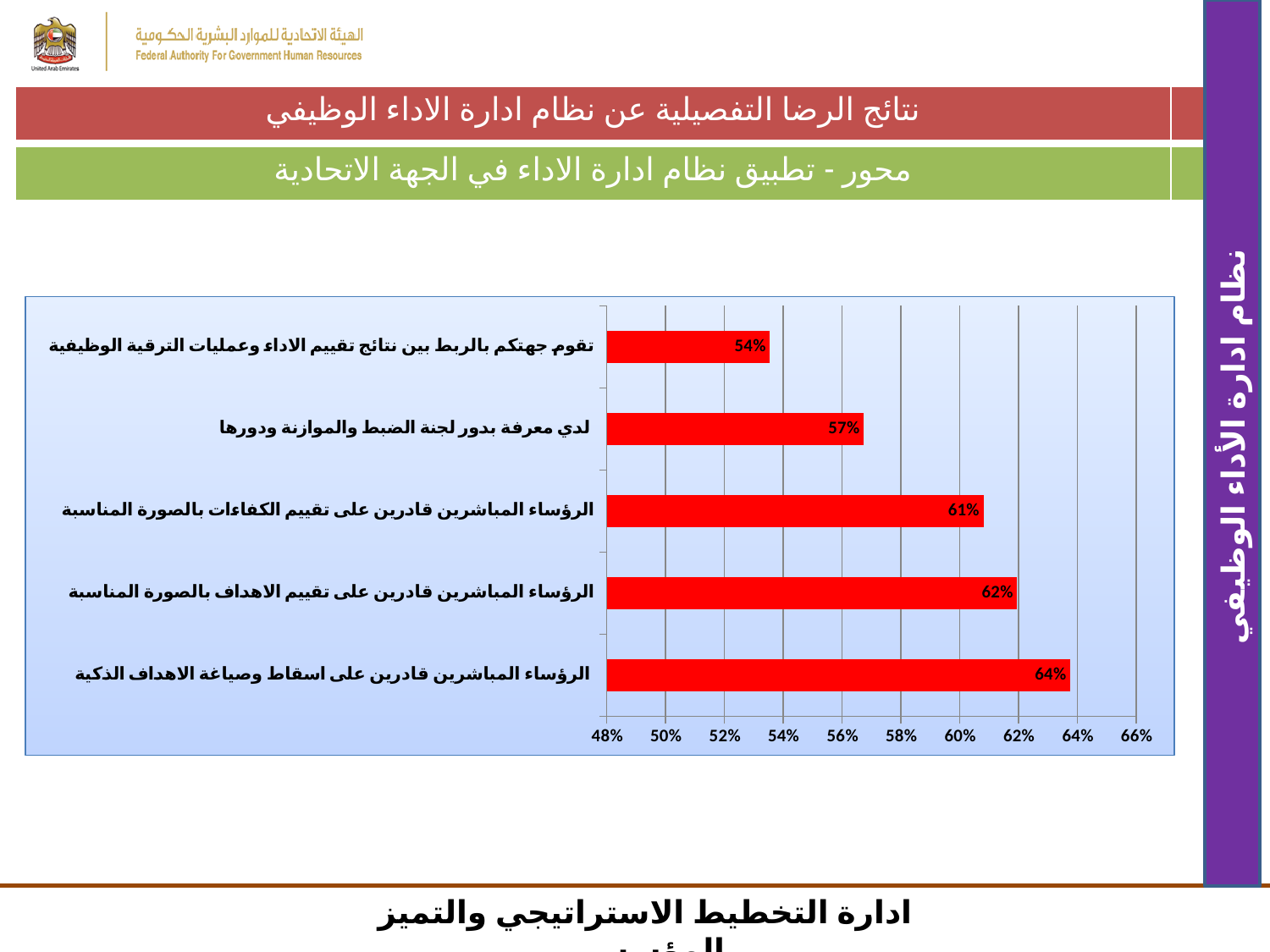
Which is larger: the value for "لدي معرفة بدور لجنة الضبط والموازنة ودورها" or the value for "الرؤساء المباشرين قادرين على تقييم الاهداف بالصورة المناسبة"? الرؤساء المباشرين قادرين على تقييم الاهداف بالصورة المناسبة What is the value for "الرؤساء المباشرين قادرين على اسقاط وصياغة الاهداف الذكية"? 64% What colour are the bars in the chart? red How many categories are shown in the chart? 5 What is the value for "لدي معرفة بدور لجنة الضبط والموازنة ودورها"? 57% What is the value for "الرؤساء المباشرين قادرين على تقييم الكفاءات بالصورة المناسبة"? 61% What is the value for "تقوم جهتكم بالربط بين نتائج تقييم الاداء وعمليات الترقية الوظيفية"? 54% Which category has the highest value? الرؤساء المباشرين قادرين على اسقاط وصياغة الاهداف الذكية Is the value for "لدي معرفة بدور لجنة الضبط والموازنة ودورها" greater or less than 60%? less What is the difference between the value for "الرؤساء المباشرين قادرين على اسقاط وصياغة الاهداف الذكية" and the value for "تقوم جهتكم بالربط بين نتائج تقييم الاداء وعمليات الترقية الوظيفية"? 10% What kind of chart is shown on the slide? bar chart Which category has the lowest value? تقوم جهتكم بالربط بين نتائج تقييم الاداء وعمليات الترقية الوظيفية